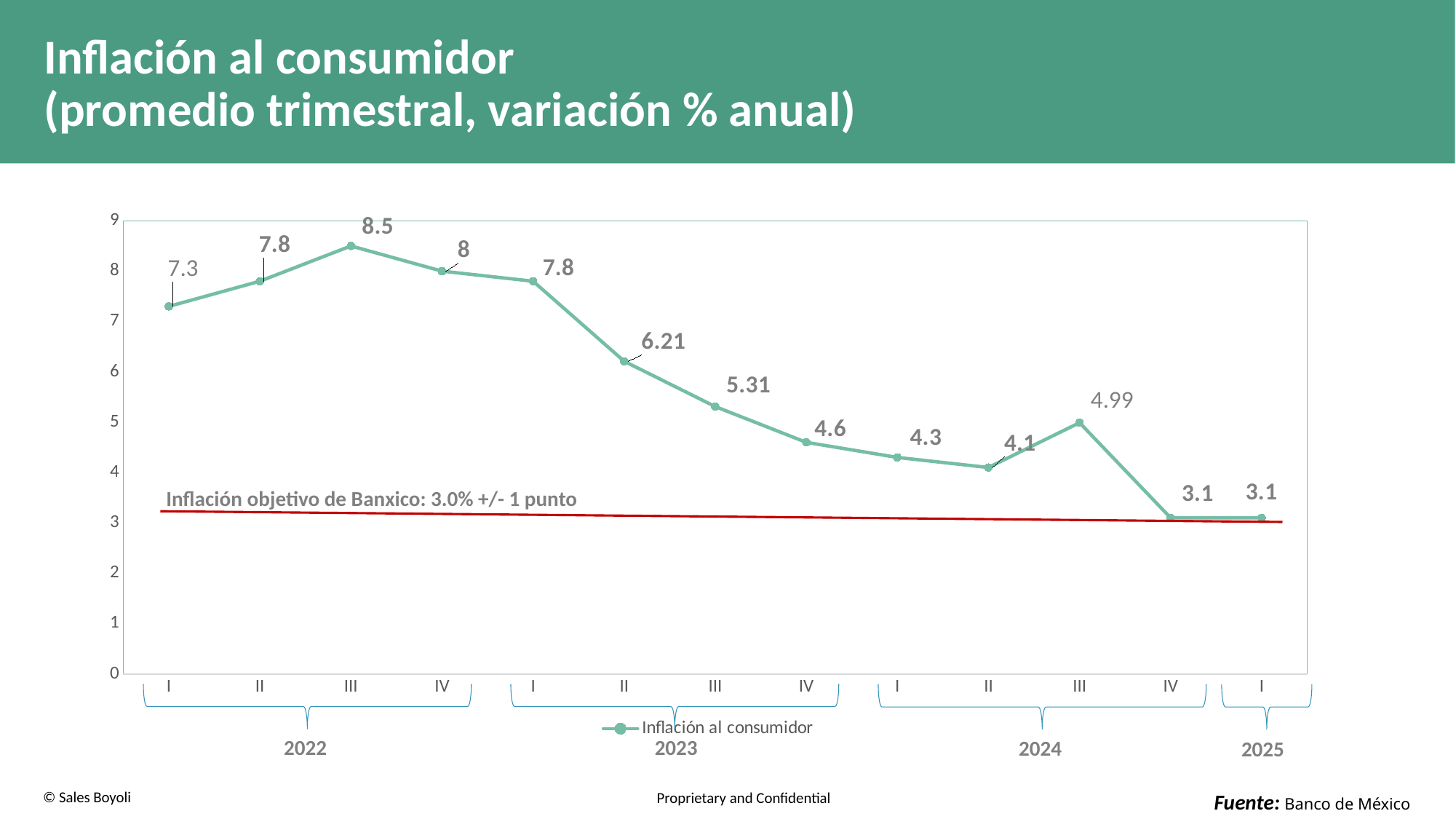
Overall, do the values rise or fall from quarter I of 2023 to quarter I of 2025? fall What is the difference between the values for quarter II of 2023 and quarter III of 2023? 0.9 How many series does the legend list? 1 What is the value for quarter I of 2025? 3.1 What is the value for quarter III of 2024? 4.99 What type of chart is shown on the slide? line chart Which quarter has the highest value? III 2022 Which is larger, the value for quarter IV of 2023 or the value for quarter III of 2024? quarter III of 2024 What is the value for quarter II of 2023? 6.21 What is the value for quarter III of 2022? 8.5 What is the difference between the values for quarter III of 2022 and quarter I of 2022? 1.2 How many data points are plotted on the line? 13